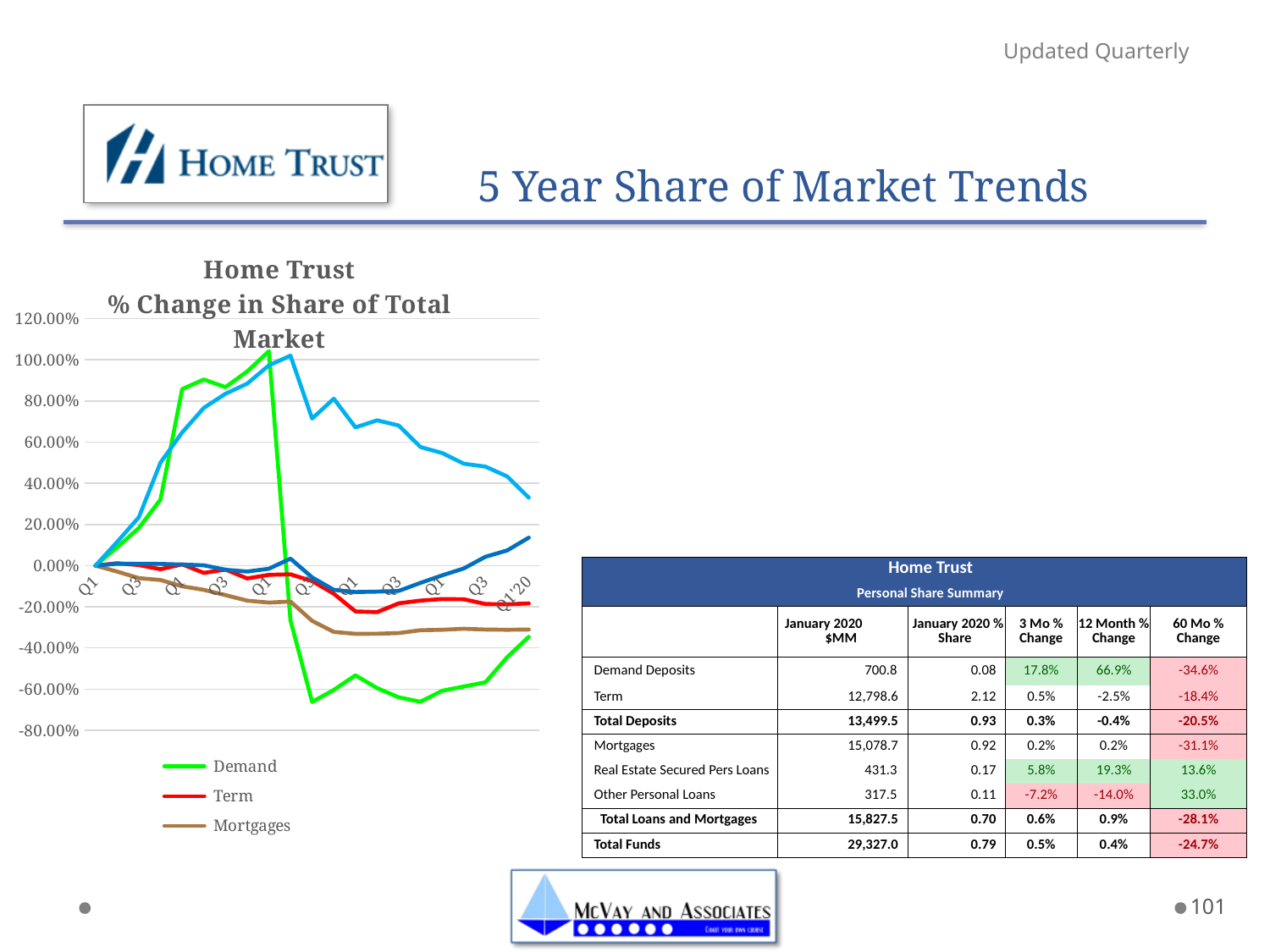
How many series does the chart legend list? 3 Does the Mortgages line generally rise or fall from the first quarter to Q1'20? Fall Is the value of the Term line at Q1'20 greater or less than 0.00%? less At Q1'20, which is higher: the Term line or the Demand line? Term Is the lowest value reached by the Demand line greater or less than -40.00%? less Of the three series in the legend, which one reaches the lowest value on the chart? Demand What kind of chart is shown on the slide? Line chart What is the title of the chart? Home Trust % Change in Share of Total Market Is the value of the Demand line at Q1'20 greater or less than -20.00%? less Which colour is used for the Demand series in the chart? Green